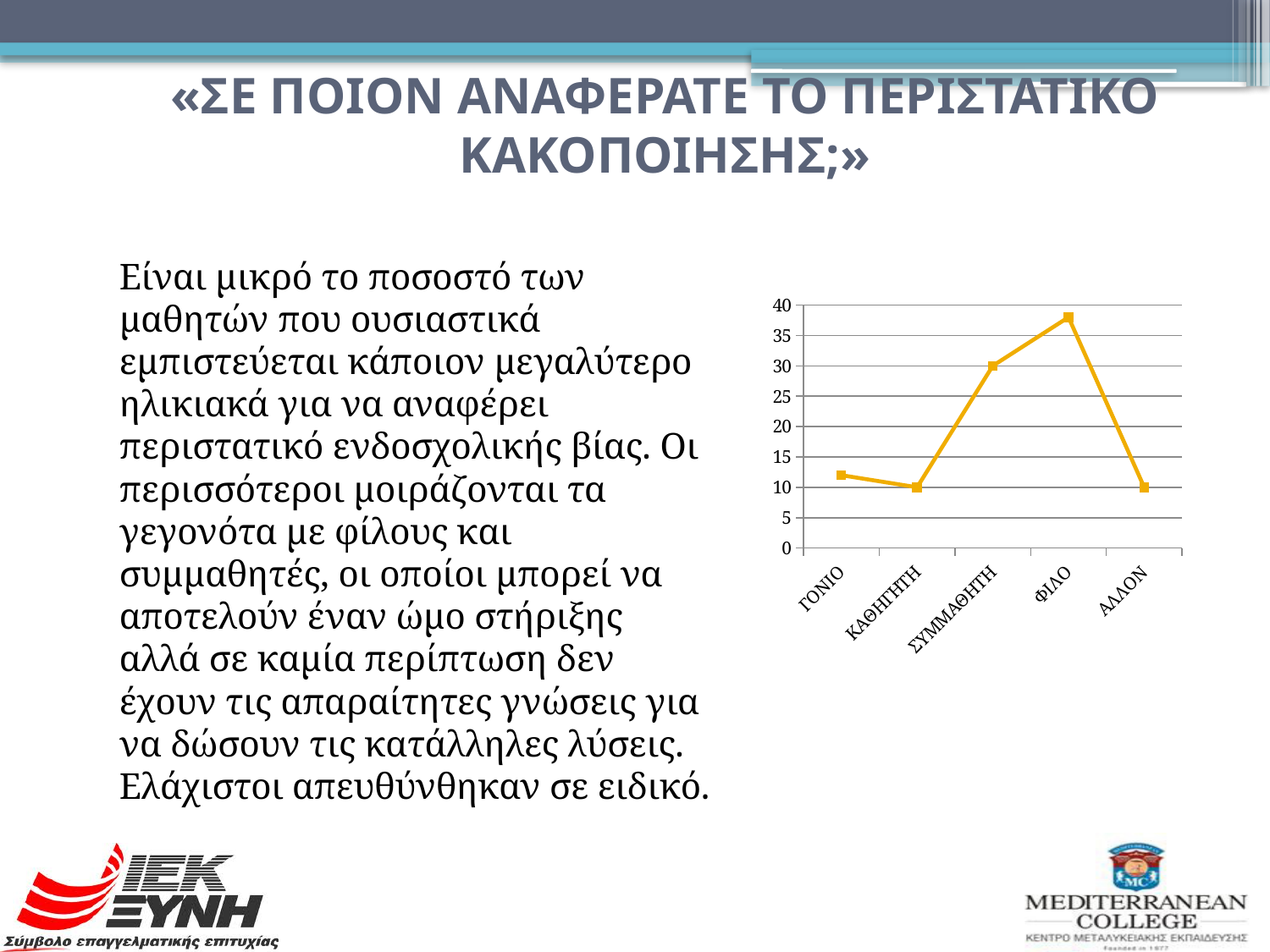
What is the value for ΚΑΘΗΓΗΤΗ? 10 What is the difference between the values for ΣΥΜΜΑΘΗΤΗ and ΚΑΘΗΓΗΤΗ? 20 Which category has the highest value in the chart? ΦΙΛΟ What is the value for ΑΛΛΟΝ? 10 Which is larger, the value for ΦΙΛΟ or the value for ΓΟΝΙΟ? ΦΙΛΟ Does the line rise or fall from ΦΙΛΟ to ΑΛΛΟΝ? fall What is the value for ΣΥΜΜΑΘΗΤΗ? 30 Is the value for ΦΙΛΟ greater or less than 35? greater Is the value for ΓΟΝΙΟ greater or less than 15? less What is the maximum value shown on the y axis of the chart? 40 How many categories are plotted on the x axis of the chart? 5 What kind of chart is shown on the slide? line chart